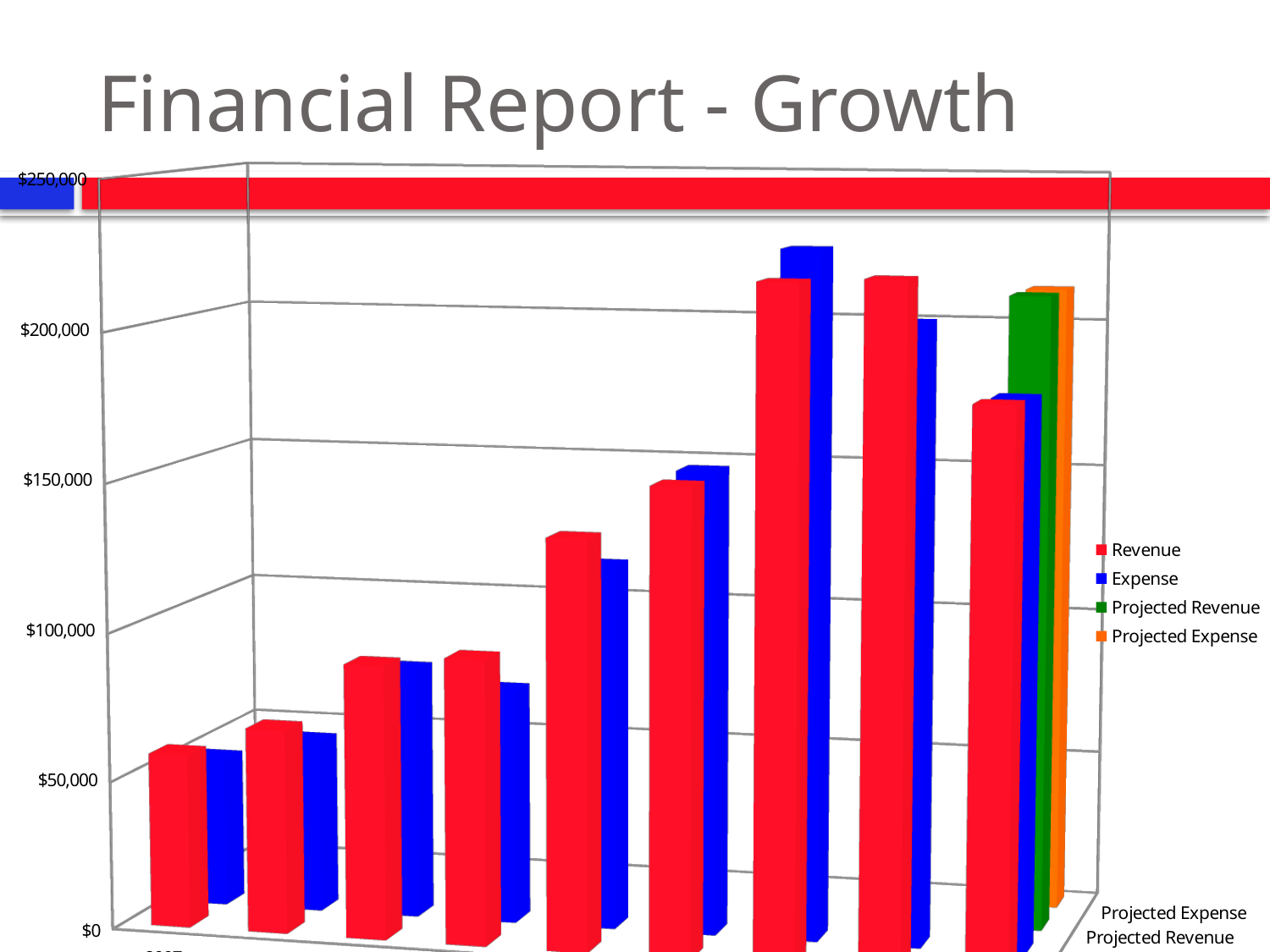
What kind of chart is shown on the slide? Bar chart In the seventh group of bars from the left, which is taller, Revenue or Expense? Expense How many bars are in the rightmost group? 4 Is the value of the Projected Revenue bar greater or less than $150,000? greater How many series does the legend list? 4 Do the Revenue bars generally rise or fall from left to right across the chart? Rise How many groups of bars are plotted along the x axis? 9 Is the value of the Projected Expense bar greater or less than $250,000? less Is the value of the leftmost Revenue bar greater or less than $100,000? less Which colour represents Projected Revenue in the chart? Green What are the four series named in the legend? Revenue, Expense, Projected Revenue, Projected Expense